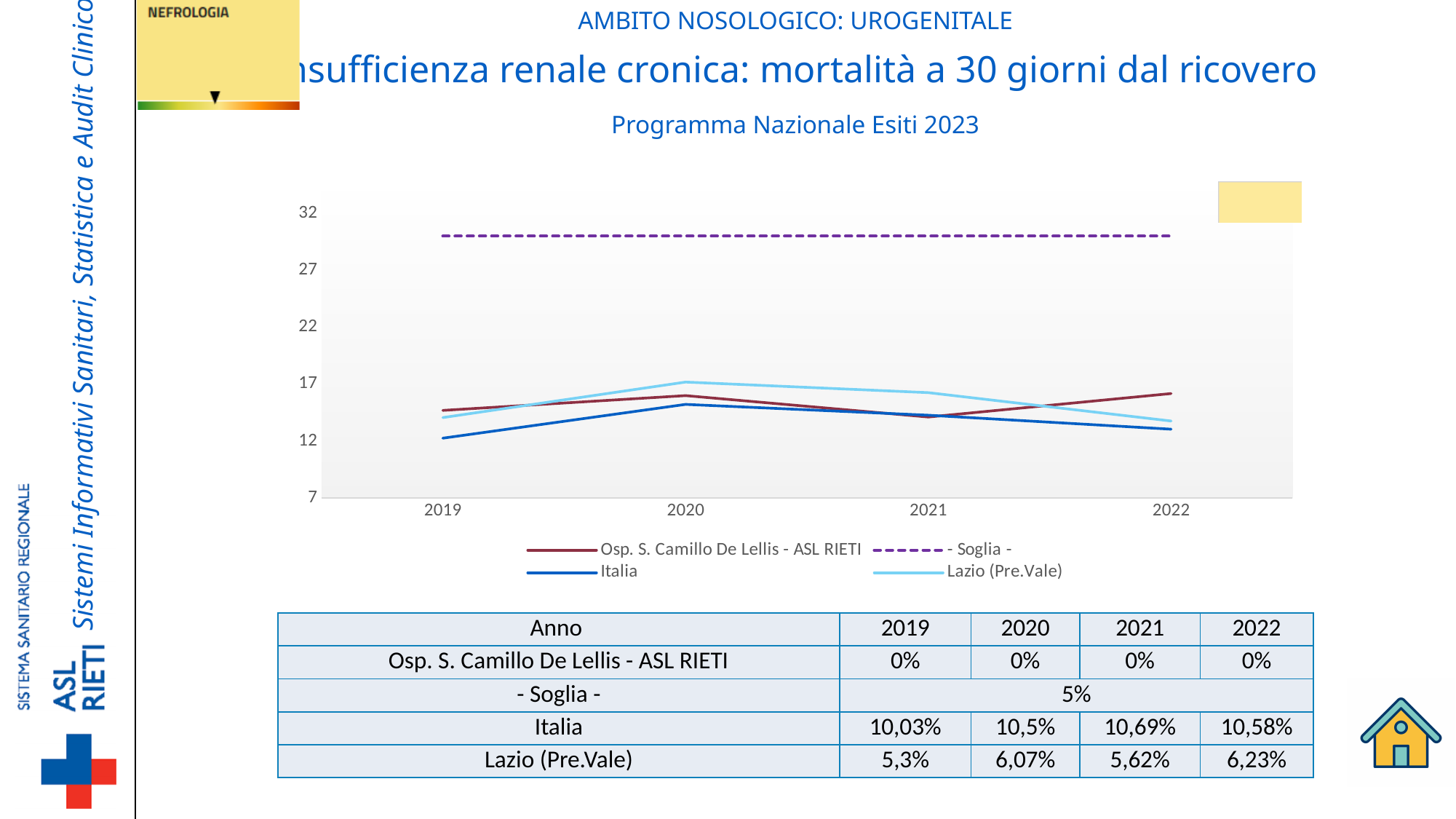
How many years are shown on the x axis of the chart? 4 Is the value of the - Soglia - line greater or less than 27? greater Is the value for Osp. S. Camillo De Lellis - ASL RIETI in 2022 greater or less than 12? greater Which series is plotted as a dashed line in the chart? - Soglia - Among the three solid lines, which series has the lowest value in 2019? Italia Is the value for Italia in 2019 greater or less than 17? less Among the three solid lines, which series has the highest value in 2022? Osp. S. Camillo De Lellis - ASL RIETI How many series does the chart legend list? 4 Which series has the highest values across all years in the chart? - Soglia - Does the Italia line rise or fall from 2020 to 2022? fall In 2022, which is larger: the value for Osp. S. Camillo De Lellis - ASL RIETI or the value for Italia? Osp. S. Camillo De Lellis - ASL RIETI What kind of chart is shown on the slide? line chart